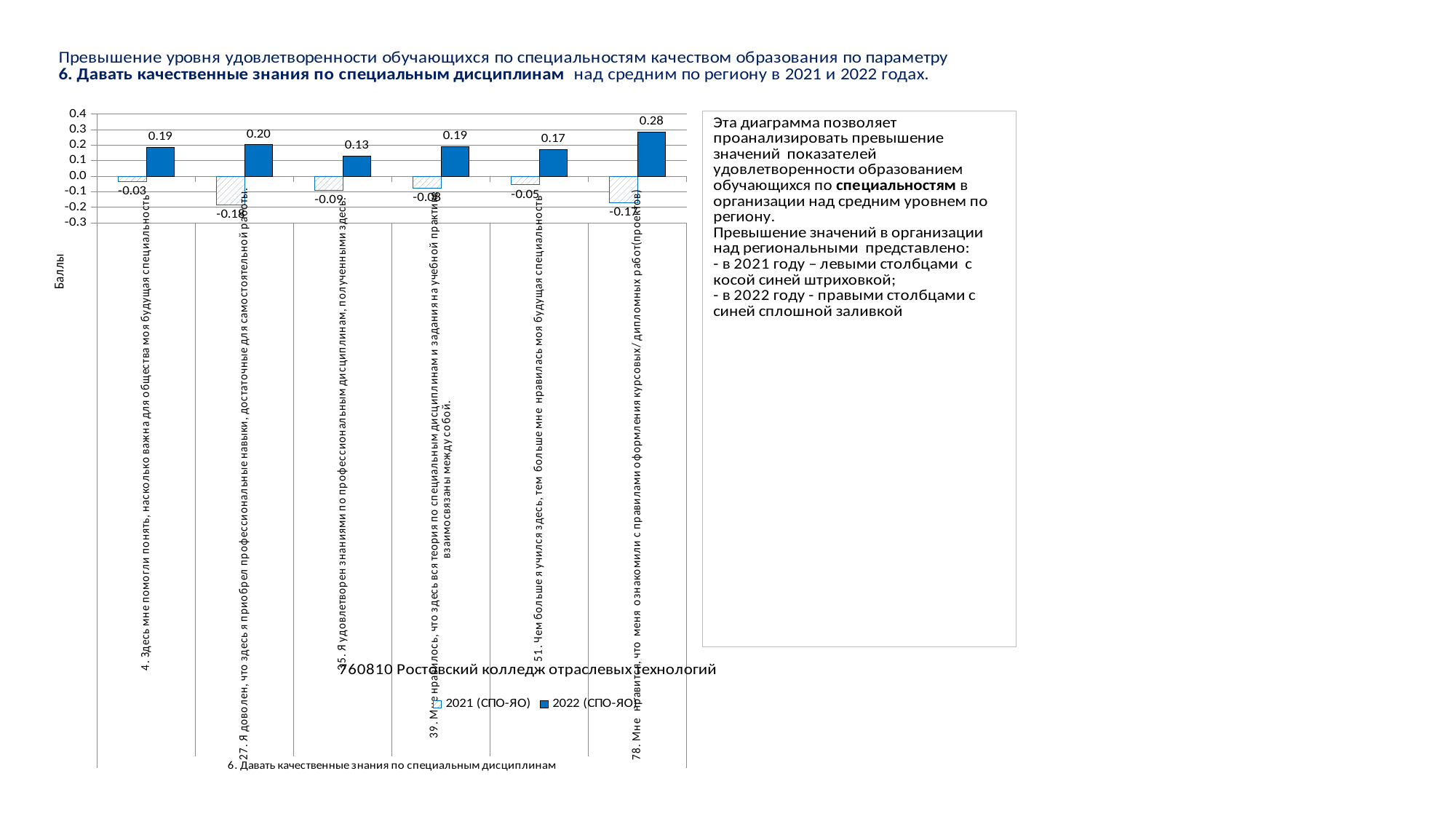
What is the 2021 (СПО-ЯО) value for statement 4? -0.03 How many categories (statements) are plotted on the x axis of the chart? 6 What is the 2022 (СПО-ЯО) value for statement 78 ("Мне нравится, что меня ознакомили с правилами оформления курсовых/дипломных работ")? 0.28 Which statement has the highest 2022 (СПО-ЯО) value? 78. Мне нравится, что меня ознакомили с правилами оформления курсовых/дипломных работ(проектов) What kind of chart is shown on the slide? bar chart How many series does the chart legend list? 2 Is the 2021 (СПО-ЯО) value for statement 27 greater or less than -0.1? less Which statement has the lowest 2022 (СПО-ЯО) value? 35. Я удовлетворен знаниями по профессиональным дисциплинам, полученными здесь Which is larger: the 2022 (СПО-ЯО) value for statement 27 or for statement 51? statement 27 What is the difference between the 2022 (СПО-ЯО) values for statement 78 and statement 35? 0.15 What is the 2021 (СПО-ЯО) value for statement 51 ("Чем больше я учился здесь, тем больше мне нравилась моя будущая специальность")? -0.05 What is the 2022 (СПО-ЯО) value for statement 4 ("Здесь мне помогли понять, насколько важна для общества моя будущая специальность")? 0.19